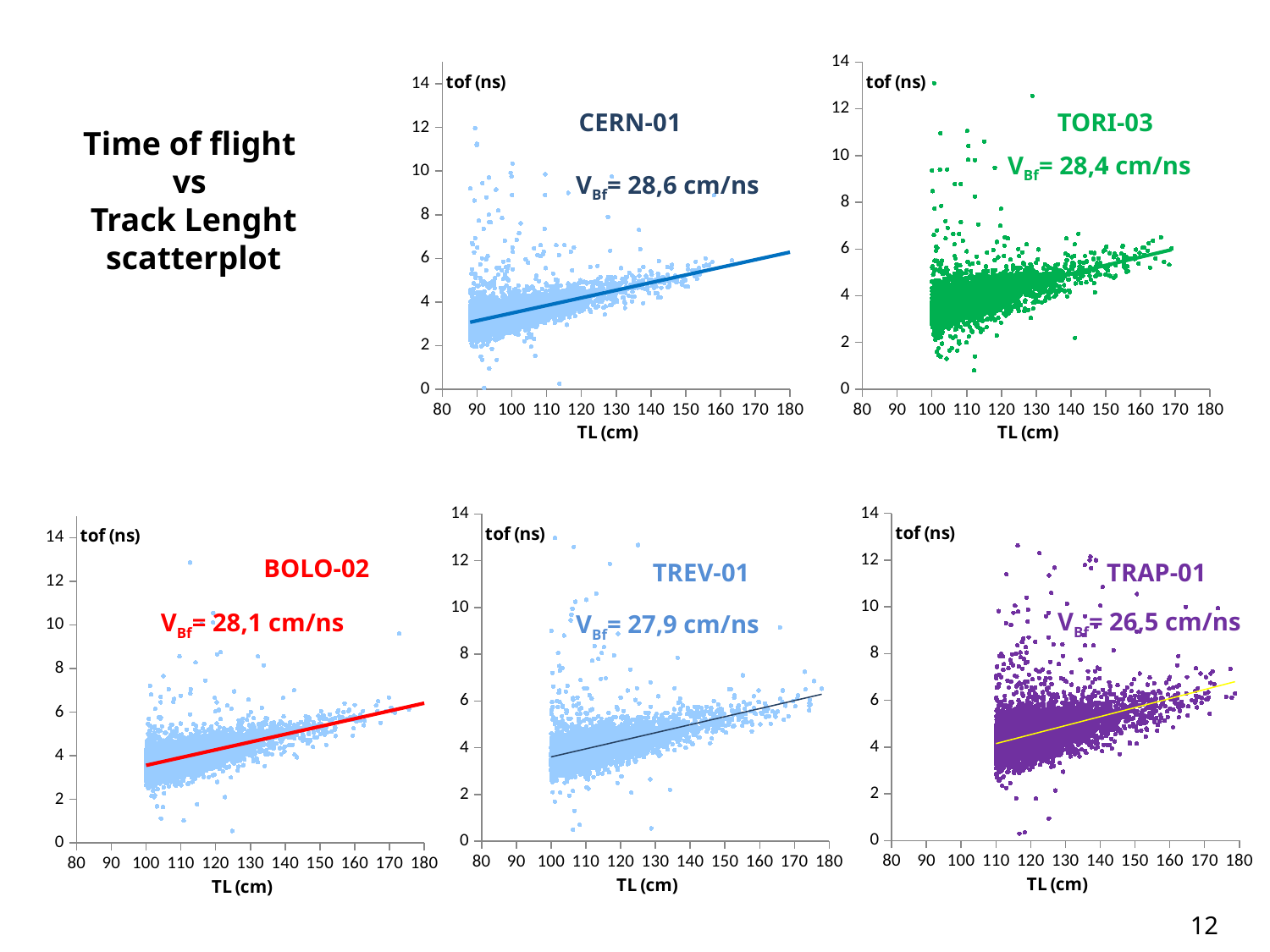
In the TRAP-01 chart, does the fitted line rise or fall as TL increases? rise What is the V_Bf value printed on the TRAP-01 chart? 26,5 cm/ns How many scatter plots are shown on the slide? 5 What is the x-axis label on the BOLO-02 chart? TL (cm) Which of the five charts shows the lowest V_Bf value? TRAP-01 What kind of chart is the CERN-01 chart? scatter plot What is the V_Bf value printed on the TORI-03 chart? 28,4 cm/ns What is the V_Bf value printed on the TREV-01 chart? 27,9 cm/ns What is the V_Bf value printed on the BOLO-02 chart? 28,1 cm/ns Which has a larger V_Bf value, BOLO-02 or TREV-01? BOLO-02 Which of the five charts shows the highest V_Bf value? CERN-01 What is the V_Bf value printed on the CERN-01 chart? 28,6 cm/ns